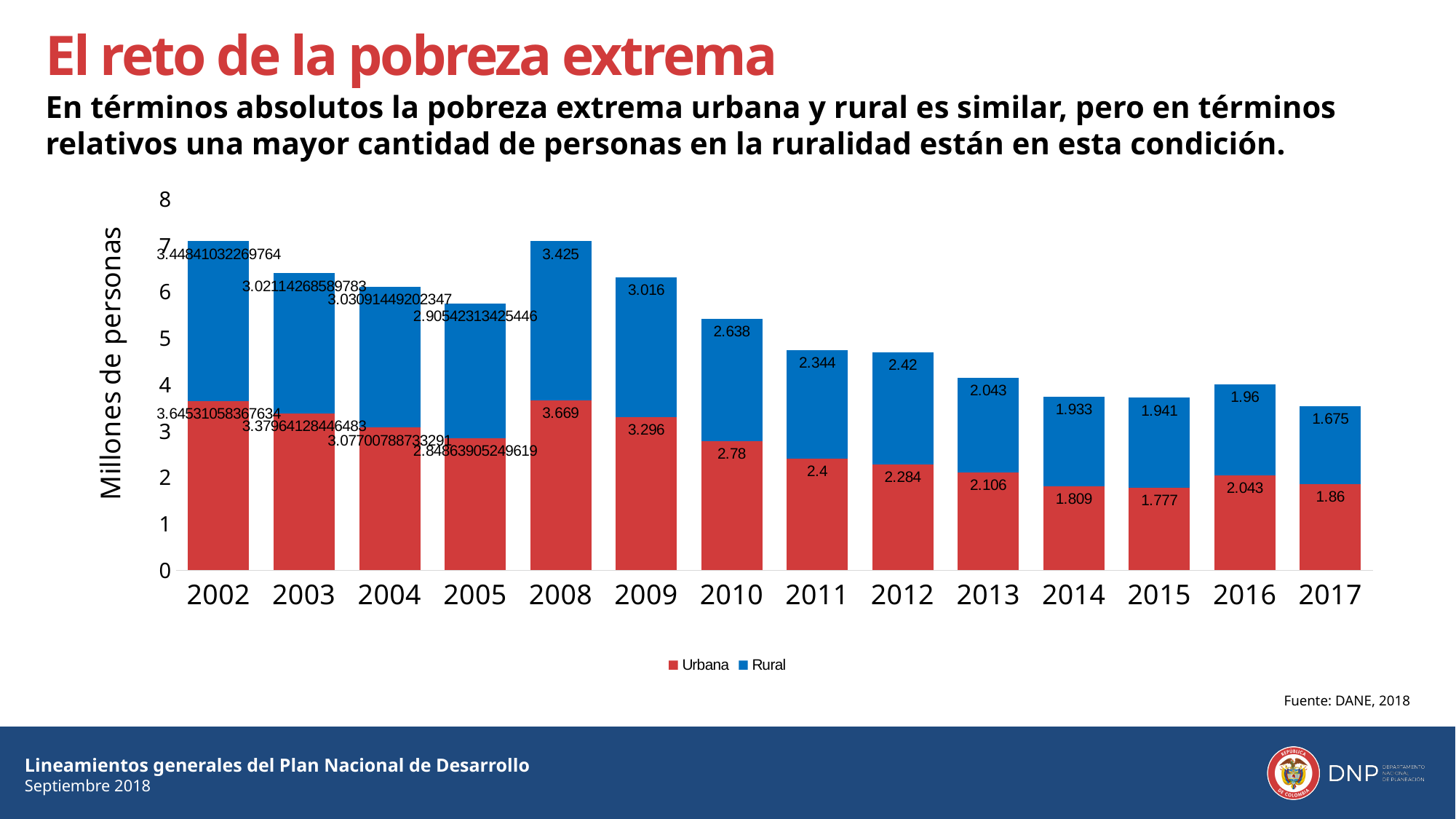
What is the difference between the Urbana and Rural values in 2008? 0.244 What is the total of the stacked bar for 2017? 3.535 Which year has the lowest Urbana value? 2015 Is the total of the stacked bar for 2010 greater or less than 5? greater How many series does the legend list? 2 How many years are shown on the x axis? 14 What is the Rural value for 2017? 1.675 What is the label of the y axis? Millones de personas What is the Urbana value for 2008? 3.669 Which year has the lowest Rural value? 2017 In 2012, which is larger, the Urbana value or the Rural value? Rural What is the Rural value for 2012? 2.42